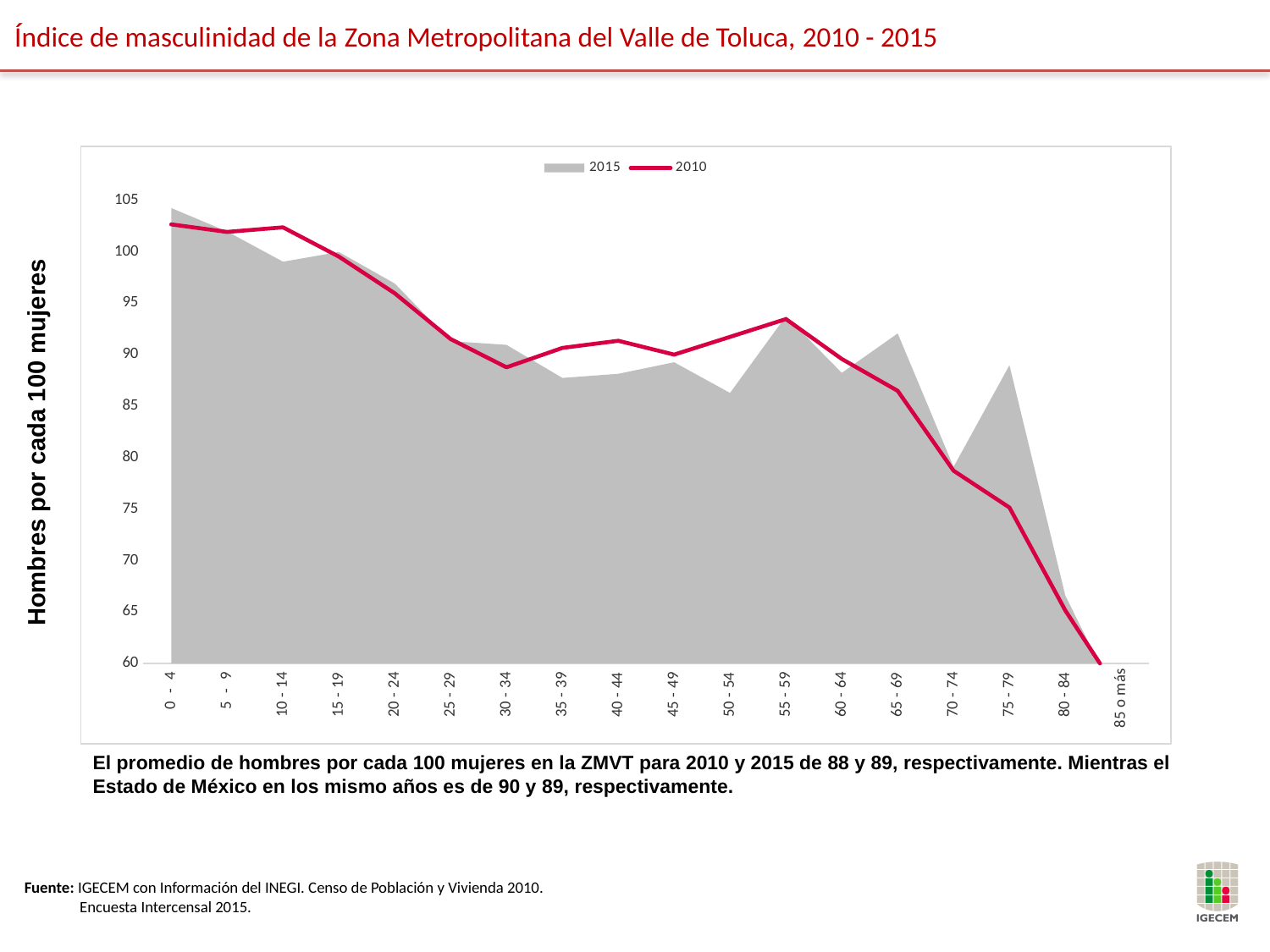
For the 75 - 79 age group, which series has the larger value, 2010 or 2015? 2015 Is the 2010 value for the 70 - 74 age group greater or less than 80? less How many age-group categories are shown on the x axis? 18 What is the title of the vertical axis? Hombres por cada 100 mujeres Is the 2015 value for the 50 - 54 age group greater or less than 90? less Overall, do the values rise or fall as the age groups increase along the x axis? fall How many series does the chart legend list? 2 What are the two series named in the legend? 2015 and 2010 Which age group has the lowest value for the 2010 series? 85 o más Which age group has the highest value for the 2015 series? 0 - 4 Is the 2010 value for the 0 - 4 age group greater or less than 100? greater What kind of chart is used to plot the 2010 series? line chart